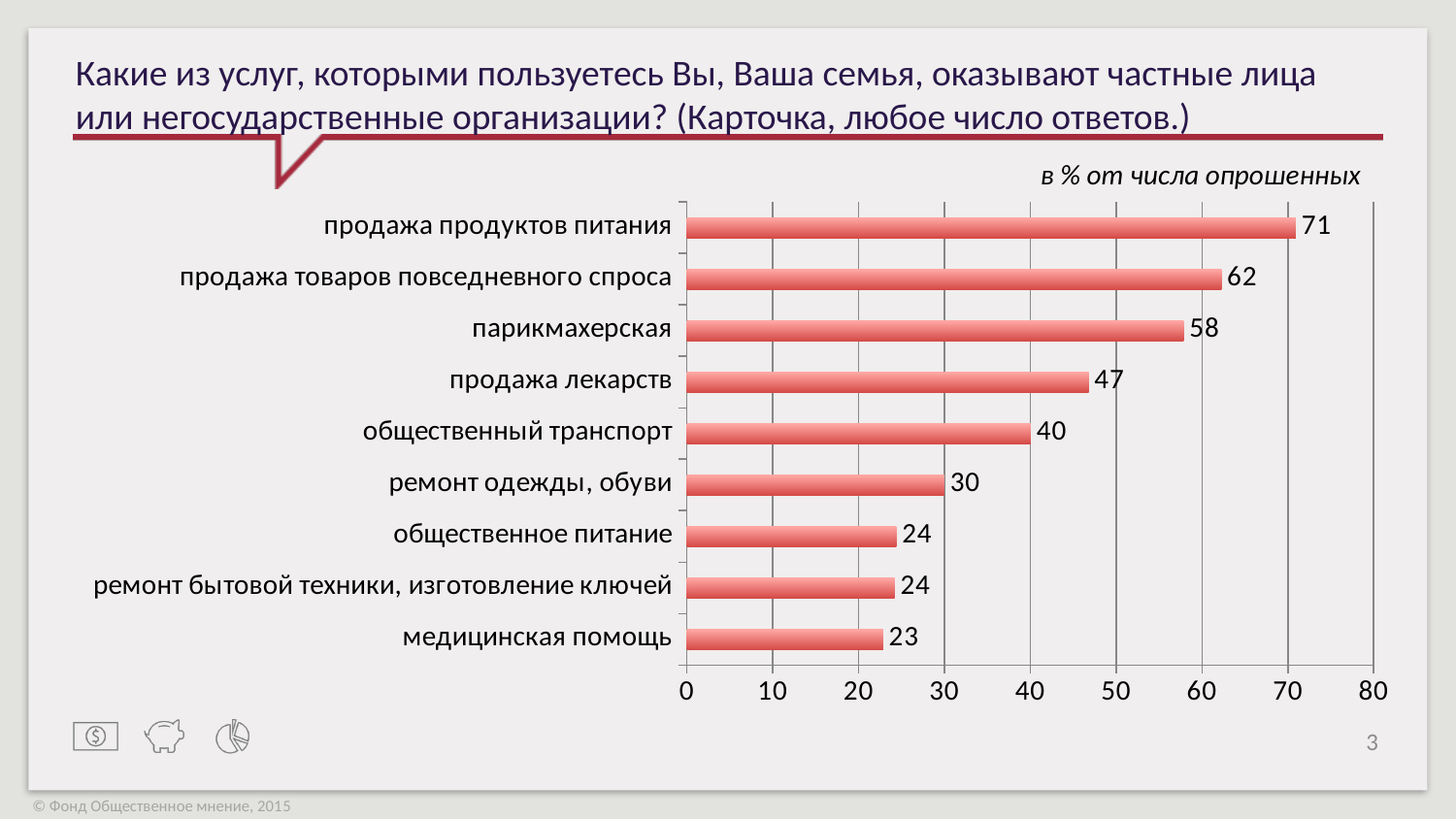
What is the difference between the values for «продажа продуктов питания» and «продажа товаров повседневного спроса»? 9 What kind of chart is shown on the slide? bar chart What unit is stated above the chart for the values? в % от числа опрошенных What is the value for «медицинская помощь»? 23 Which category has the lowest value? медицинская помощь Is the value for «продажа лекарств» greater or less than 40? greater What is the value for «продажа продуктов питания»? 71 What is the value for «общественный транспорт»? 40 Which category has the highest value? продажа продуктов питания How many categories are shown in the chart? 9 Which is larger: the value for «продажа лекарств» or the value for «ремонт одежды, обуви»? продажа лекарств What is the value for «парикмахерская»? 58